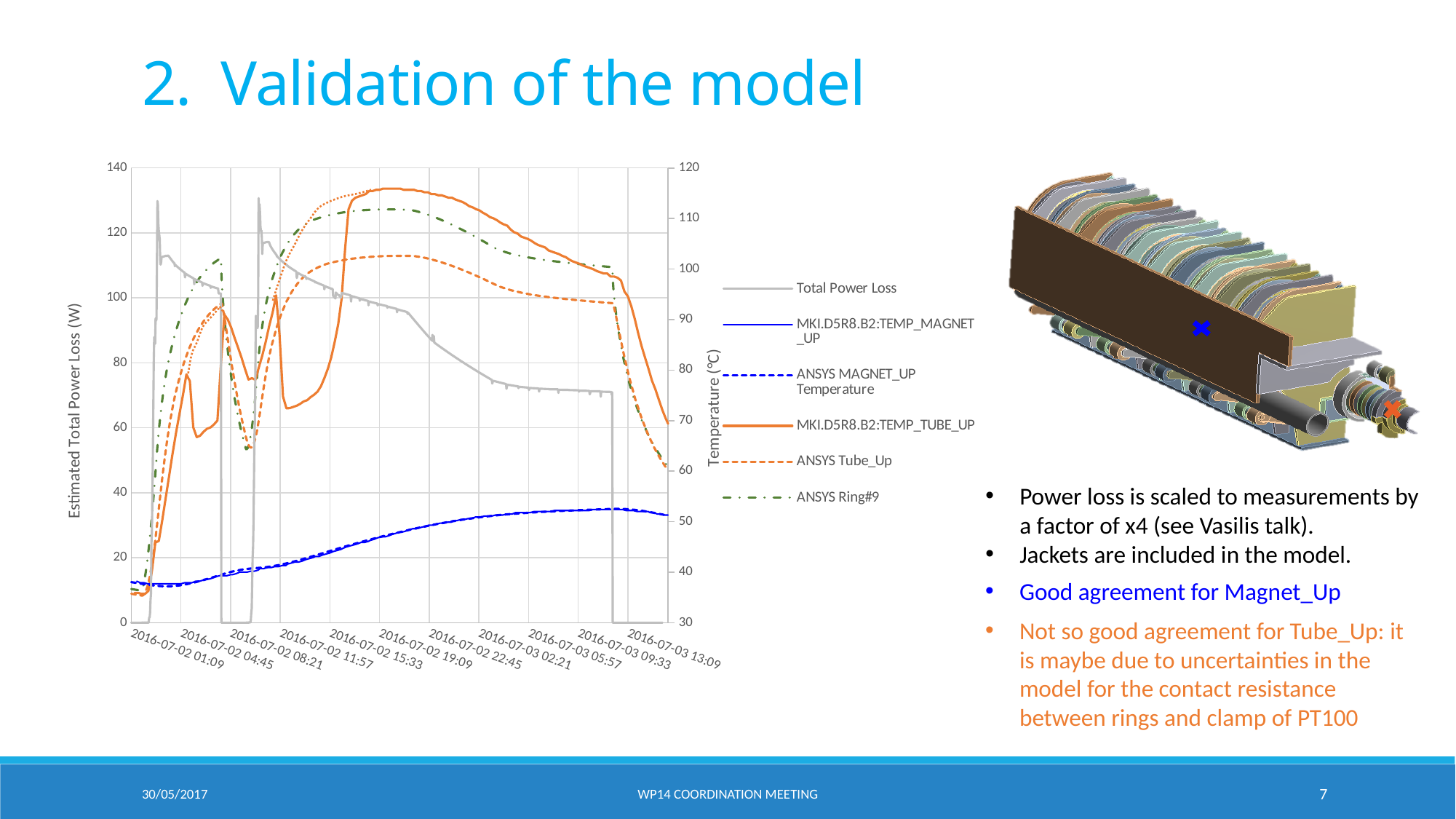
What kind of chart is shown on the slide? line chart Does MKI.D5R8.B2:TEMP_MAGNET_UP rise or fall between 2016-07-02 08:21 and 2016-07-03 05:57? rise How many date-time tick labels are shown on the x axis of the chart? 11 Which series reaches a higher peak temperature, ANSYS Tube_Up or ANSYS Ring#9? ANSYS Ring#9 Which series reaches a higher peak temperature, MKI.D5R8.B2:TEMP_TUBE_UP or MKI.D5R8.B2:TEMP_MAGNET_UP? MKI.D5R8.B2:TEMP_TUBE_UP What is the label of the left vertical axis of the chart? Estimated Total Power Loss (W) Is the highest temperature reached by MKI.D5R8.B2:TEMP_MAGNET_UP greater or less than 60? less What is the label of the right vertical axis of the chart? Temperature (°C) How many series does the chart's legend list? 6 Is the highest temperature reached by MKI.D5R8.B2:TEMP_TUBE_UP greater or less than 110? greater Is the Total Power Loss at 2016-07-03 05:57 greater or less than 60? greater